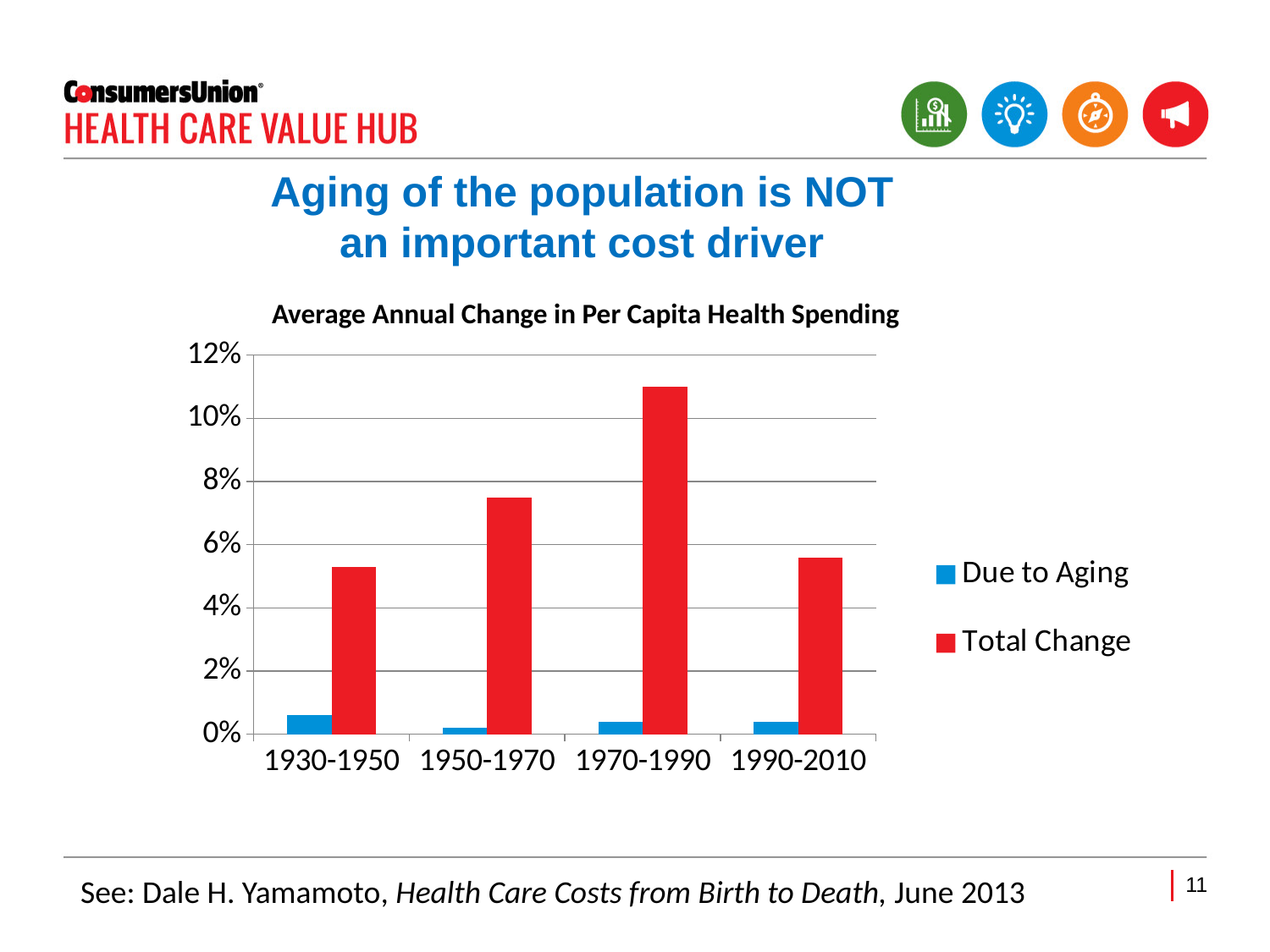
How many time periods are shown on the x axis? 4 Is the Total Change value for 1930-1950 greater or less than 4%? greater Which series is shown in red? Total Change Which period has the highest Total Change? 1970-1990 Is the Due to Aging value for 1930-1950 greater or less than 2%? less What is the title of the chart? Average Annual Change in Per Capita Health Spending Which is larger, the Total Change for 1950-1970 or the Total Change for 1930-1950? 1950-1970 Is the Total Change value for 1950-1970 greater or less than 8%? less Which period has the lowest Due to Aging value? 1950-1970 How many series does the legend list? 2 What kind of chart is shown on the slide? bar chart